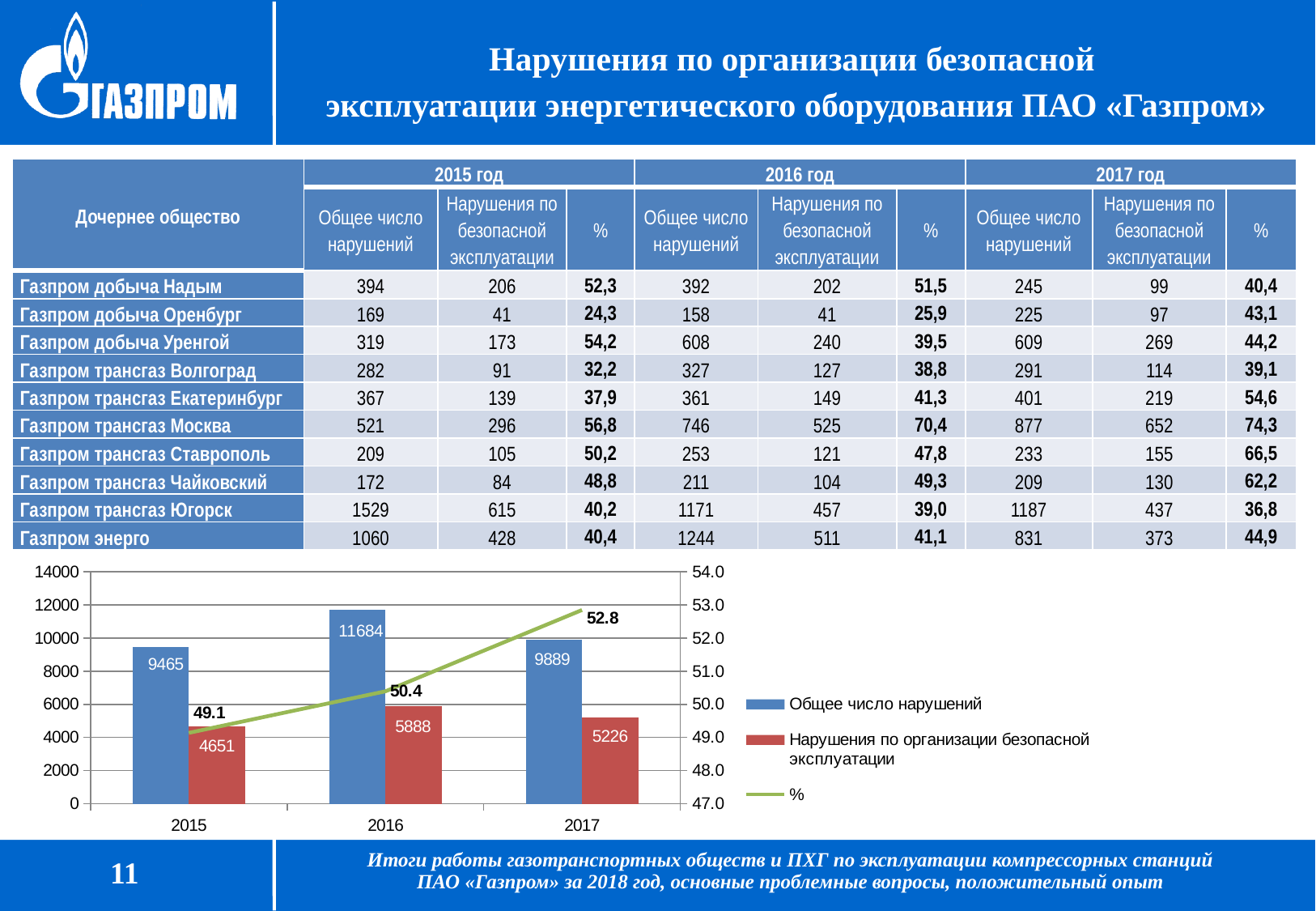
Is the value of "Общее число нарушений" for 2017 greater or less than 8000? greater Which year has the lowest value of "Нарушения по организации безопасной эксплуатации" in the chart? 2015 Which is larger in the chart: "Нарушения по организации безопасной эксплуатации" in 2016 or in 2017? 2016 What colour are the bars for "Общее число нарушений" in the chart? blue Which year has the highest value of "Общее число нарушений" in the chart? 2016 How many series does the chart legend list? 3 What is the value of "Нарушения по организации безопасной эксплуатации" for 2017 in the chart? 5226 Does the "%" line rise or fall from 2015 to 2017? rises What is the "%" value shown for 2015 in the chart? 49.1 How many years are shown on the x axis of the chart? 3 What is the value of "Общее число нарушений" for 2016 in the chart? 11684 What is the difference between "Общее число нарушений" in 2016 and in 2015? 2219